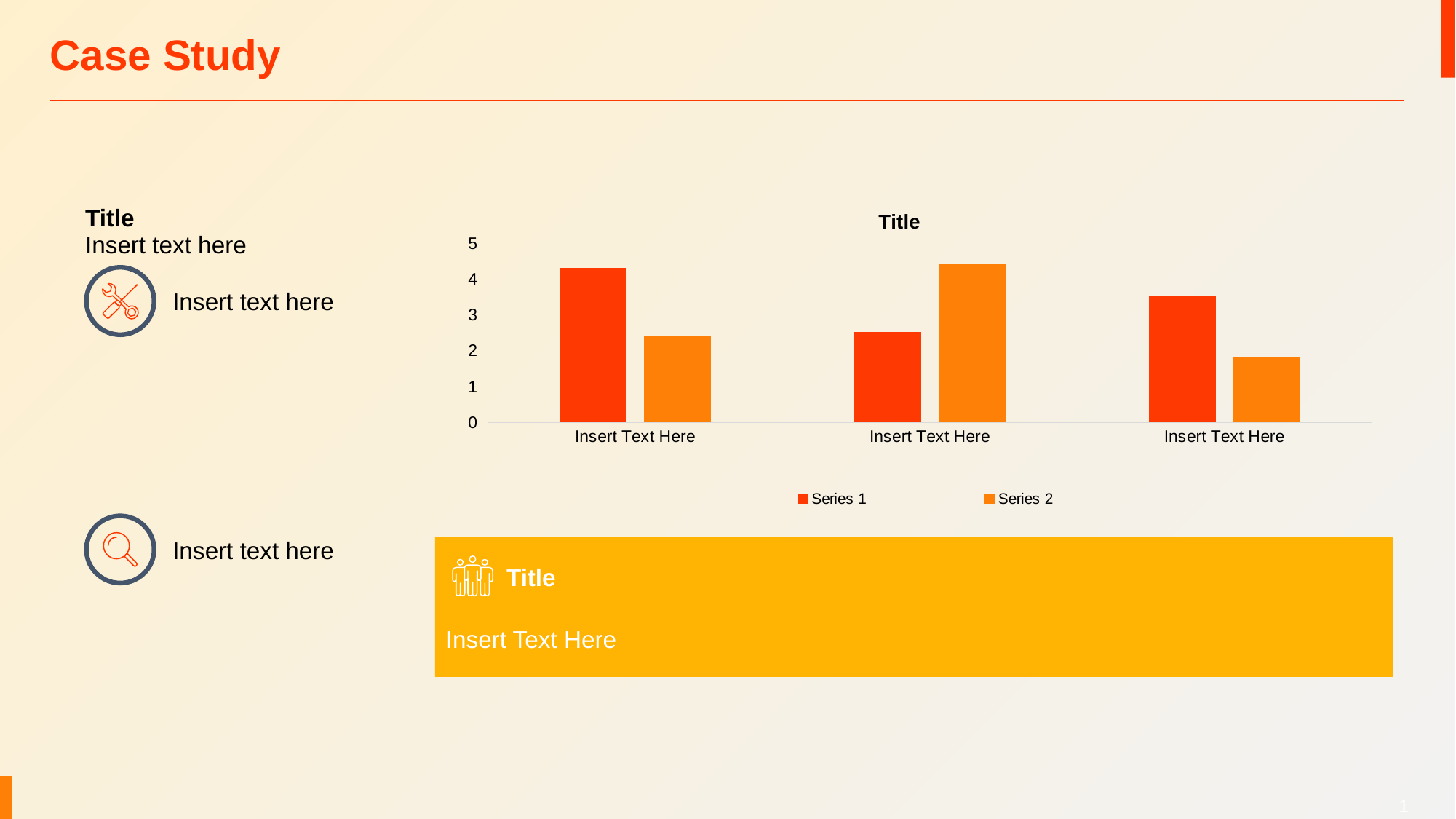
Is the Series 2 value for the third category greater or less than 2? less Is the Series 2 value for the second category greater or less than 4? greater How many series does the chart legend list? 2 What kind of chart is shown on the slide? bar chart How many categories are shown along the x axis of the chart? 3 Is the Series 1 value for the first category greater or less than 4? greater For Series 2, which category (first, second or third) has the lowest value? third In the second category, which series has the larger value, Series 1 or Series 2? Series 2 What is the title of the chart? Title In the first category, which series has the larger value, Series 1 or Series 2? Series 1 What are the names of the two series in the chart legend? Series 1 and Series 2